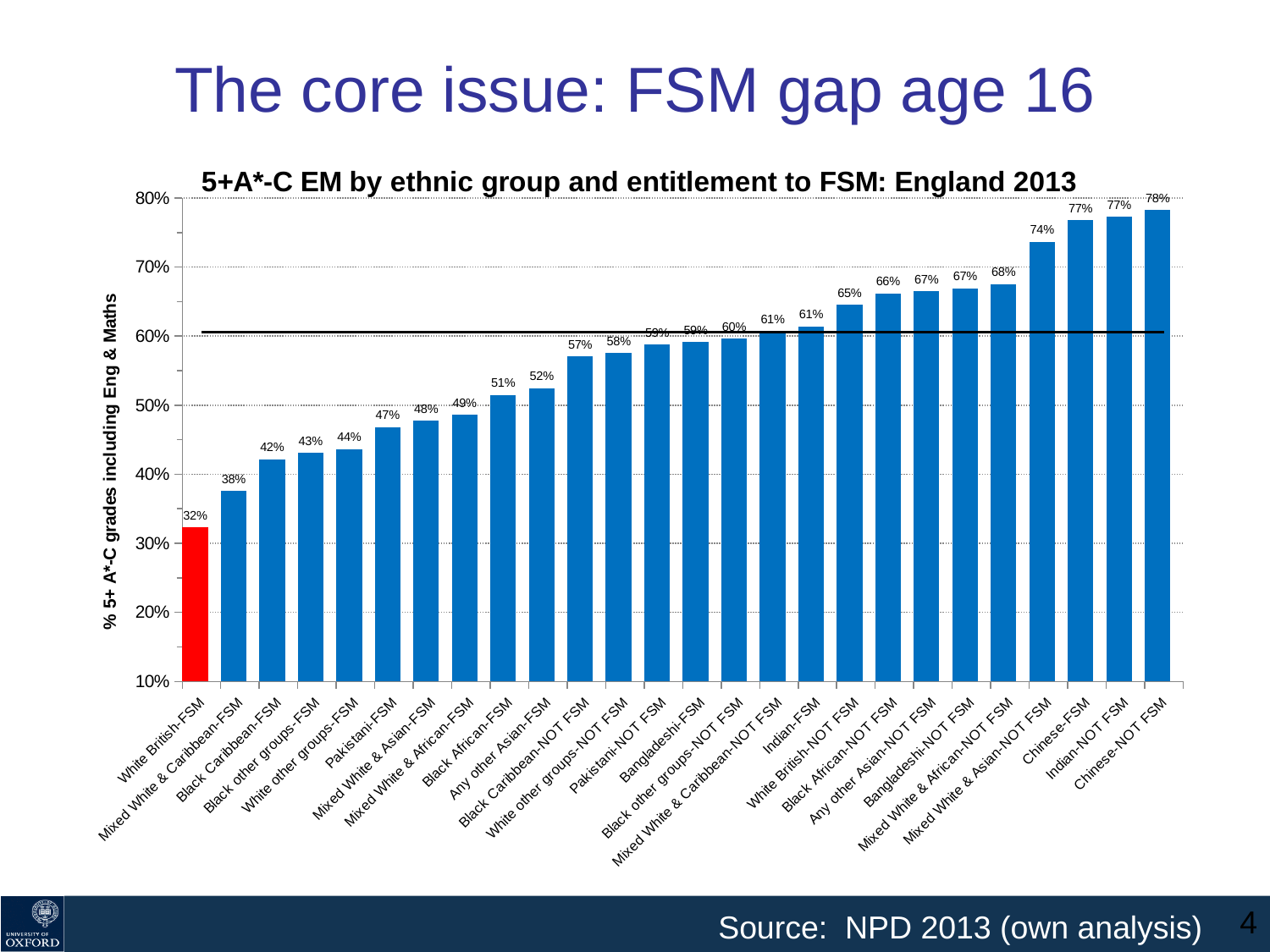
What is the value for White British-FSM? 32% What is the value for Indian-FSM? 61% Is the value for Mixed White & Asian-NOT FSM greater or less than 70%? greater How many bars are plotted in the chart? 26 Which category has the highest value? Chinese-NOT FSM What kind of chart is shown on the slide? Bar chart Which bar is coloured red rather than blue? White British-FSM What is the difference between the values for White British-NOT FSM and White British-FSM? 33% What is the value for Pakistani-FSM? 47% Which category has the lowest value? White British-FSM Which is larger, the value for Black African-FSM or the value for Black Caribbean-FSM? Black African-FSM What is the value for Chinese-FSM? 77%